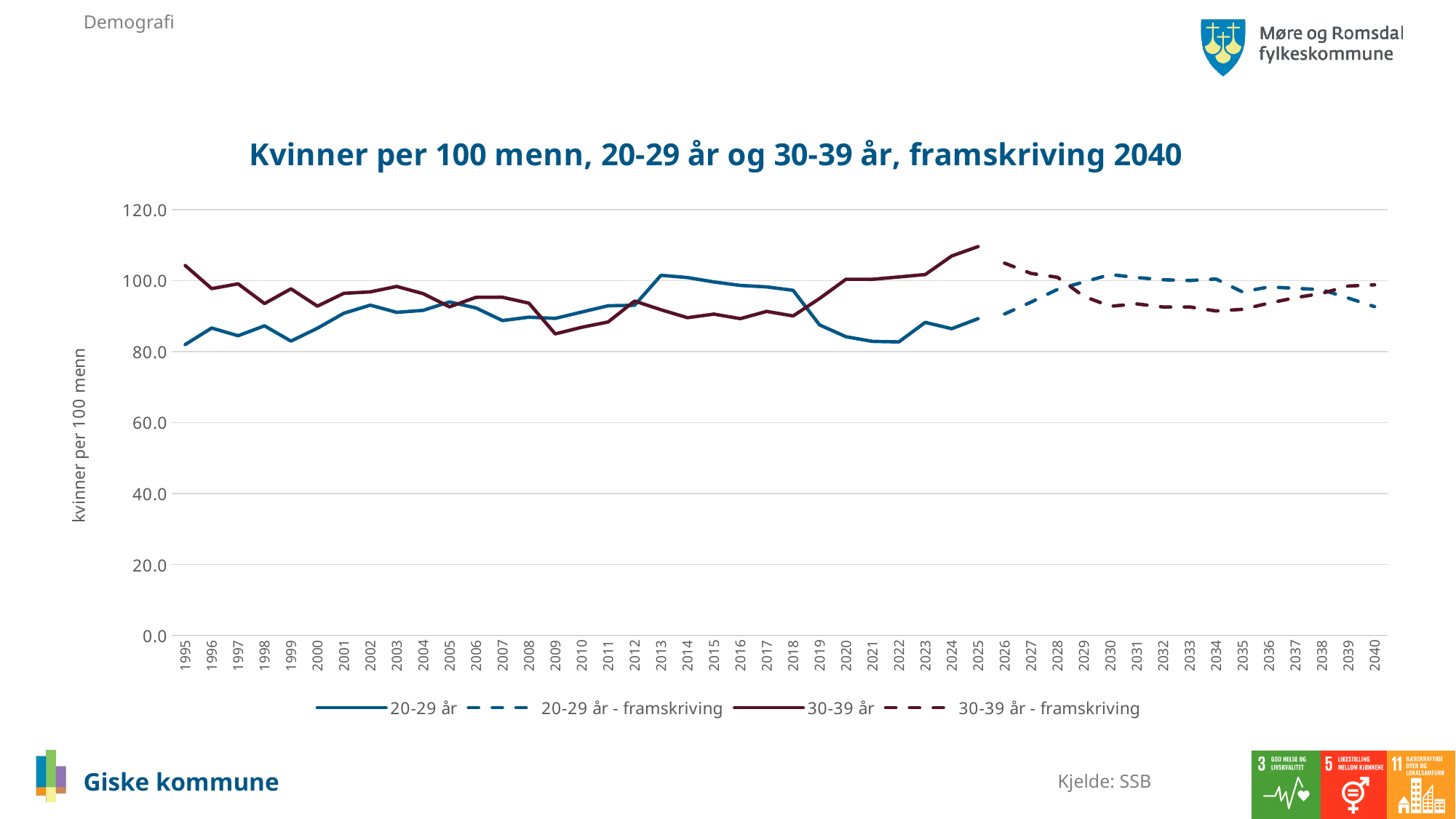
What is the title of the chart? Kvinner per 100 menn, 20-29 år og 30-39 år, framskriving 2040 In 2025, which series has the higher value, 20-29 år or 30-39 år? 30-39 år In 2013, which series has the higher value, 20-29 år or 30-39 år? 20-29 år Is the value for 20-29 år in 1995 greater or less than 100? less Is the value for 30-39 år in 2025 greater or less than 100? greater Is the value for 30-39 år - framskriving in 2034 greater or less than 100? less What kind of chart is shown on the slide? line chart How many series does the legend list? 4 What is the label on the vertical axis? kvinner per 100 menn Does the 30-39 år series rise or fall between 2019 and 2025? rise